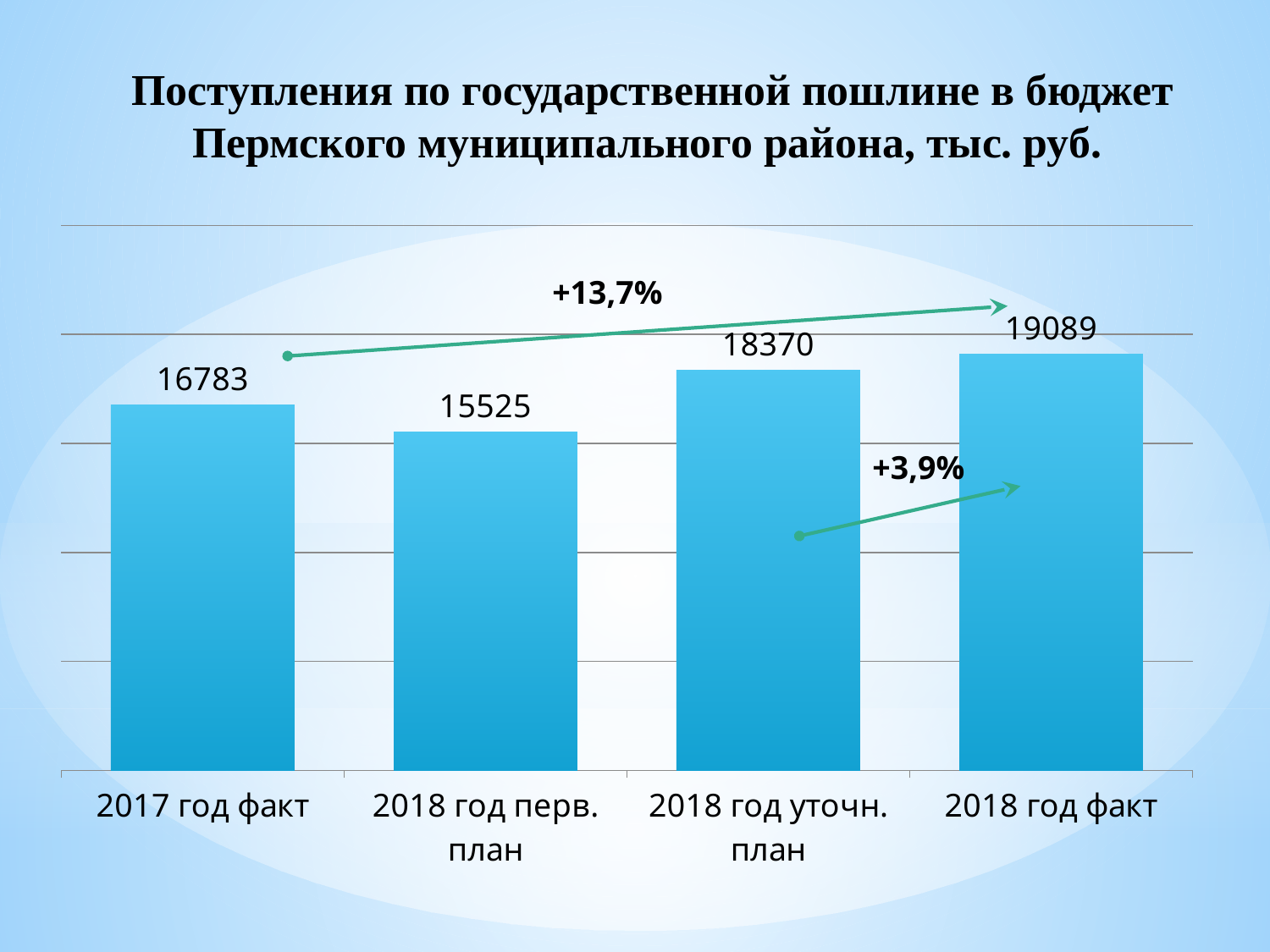
Which is larger, the value for 2017 год факт or the value for 2018 год перв. план? 2017 год факт Which category has the lowest value? 2018 год перв. план What is the value for 2018 год уточн. план? 18370 How many categories are shown on the chart? 4 What is the difference between the values for 2018 год факт and 2017 год факт? 2306 What is the difference between the values for 2018 год уточн. план and 2018 год перв. план? 2845 What is the value for 2017 год факт? 16783 What kind of chart is shown on the slide? bar chart What is the value for 2018 год перв. план? 15525 What is the value for 2018 год факт? 19089 Which category has the highest value? 2018 год факт What percentage change is annotated between 2017 год факт and 2018 год факт? +13,7%